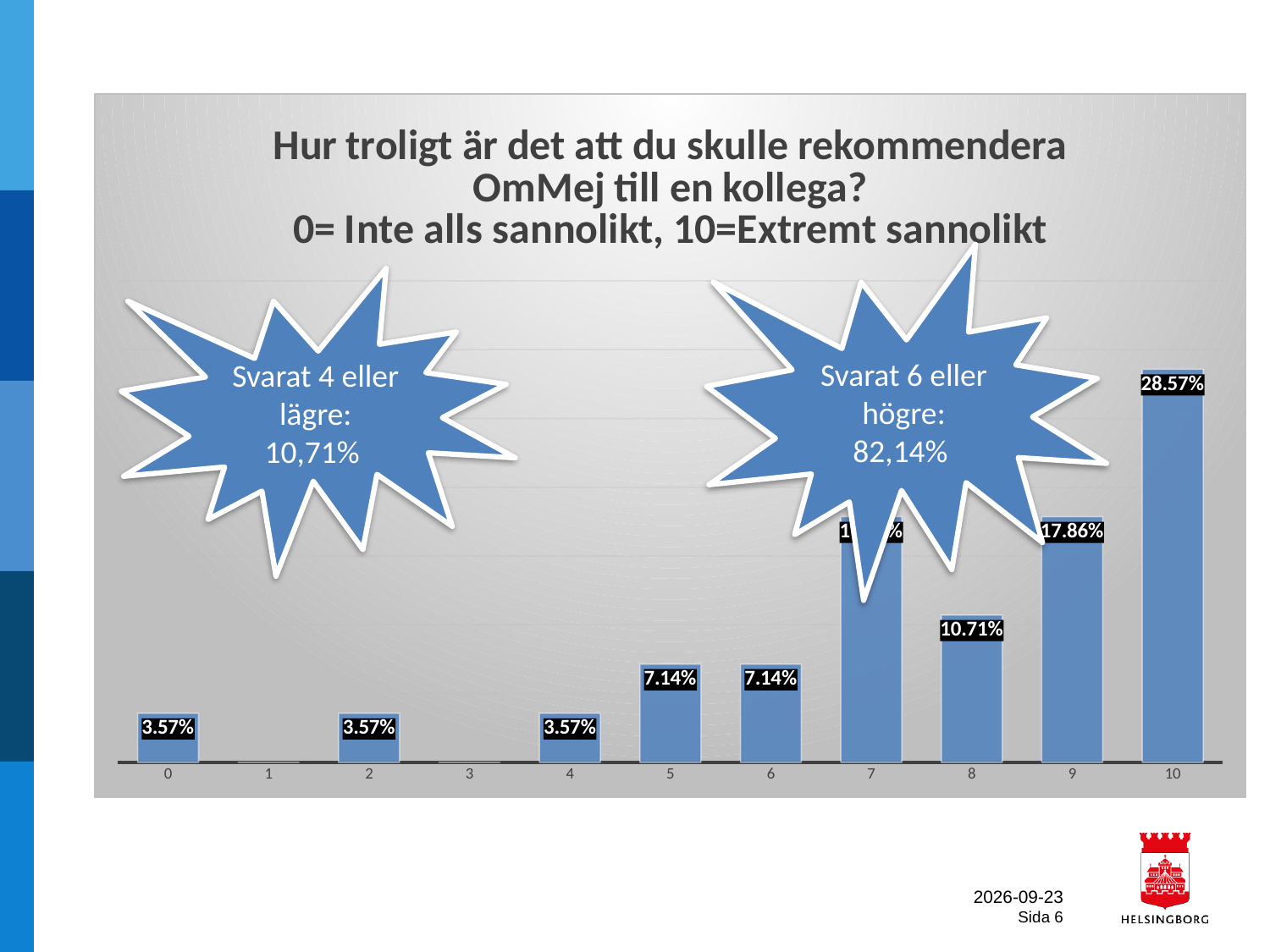
How many categories are shown on the x axis? 11 What is the value for category 5? 7.14% What is the difference between the values for category 9 and category 8? 7.15% What is the value for category 10? 28.57% What is the difference between the values for category 10 and category 9? 10.71% What is the value for category 8? 10.71% According to the starburst on the right, what share answered 6 or higher? 82,14% What kind of chart is shown on the slide? bar chart Which category has the highest value? 10 What is the value for category 9? 17.86% What is the value for category 0? 3.57% Which has the larger value, category 8 or category 5? 8